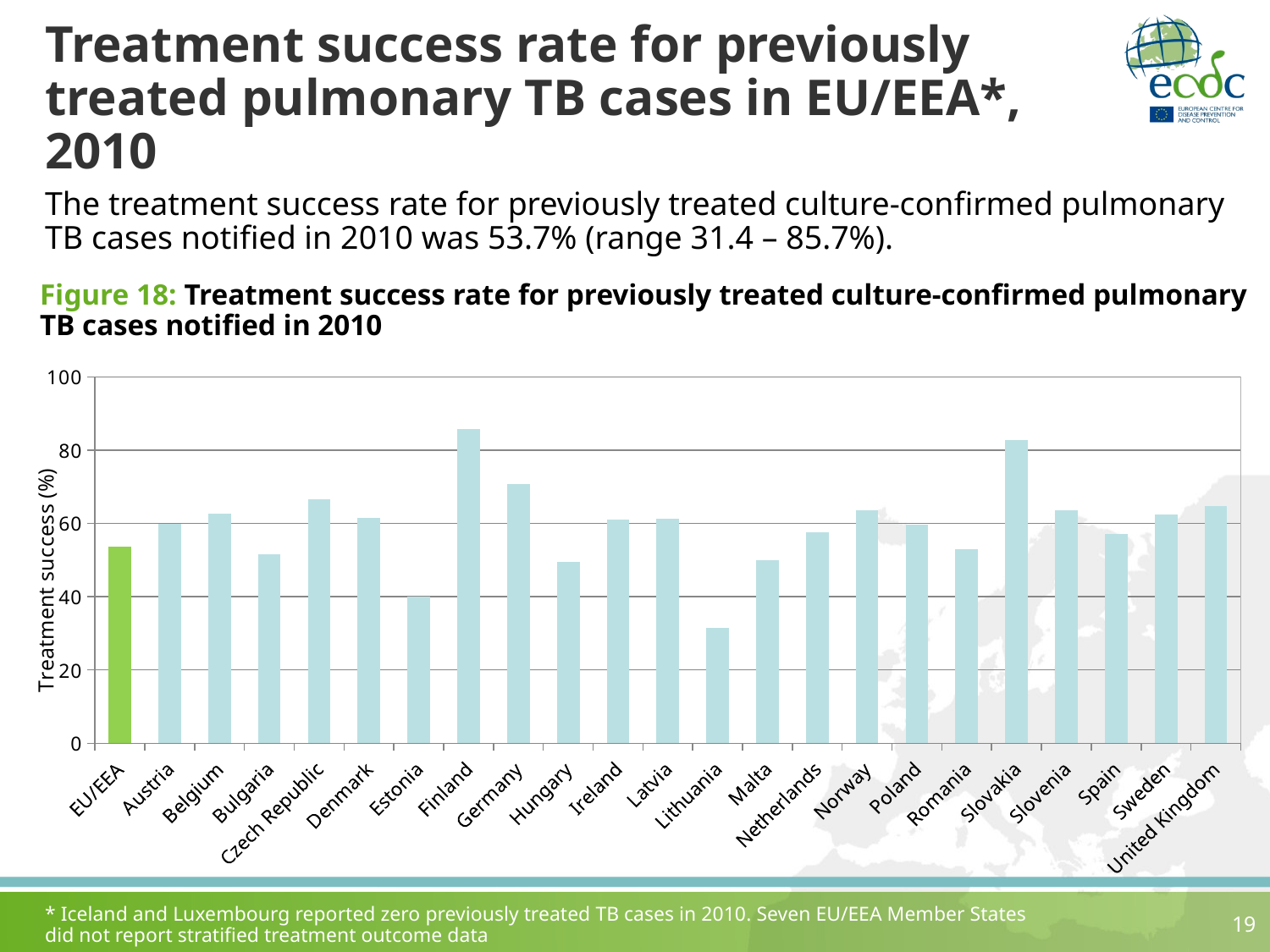
Which category has the lowest treatment success rate in the chart? Lithuania Is the value for Lithuania greater or less than 40? less Which has a lower treatment success rate, Estonia or Czech Republic? Estonia Which has a higher treatment success rate, Germany or Hungary? Germany Is the value for Slovakia greater or less than 80? greater What type of chart is shown on the slide? bar chart Is the value for Romania greater or less than 60? less Which category has the highest treatment success rate in the chart? Finland How many categories are plotted on the x axis of the chart? 23 What is the label of the y axis of the chart? Treatment success (%) What is the treatment success rate for EU/EEA shown on the slide? 53.7%